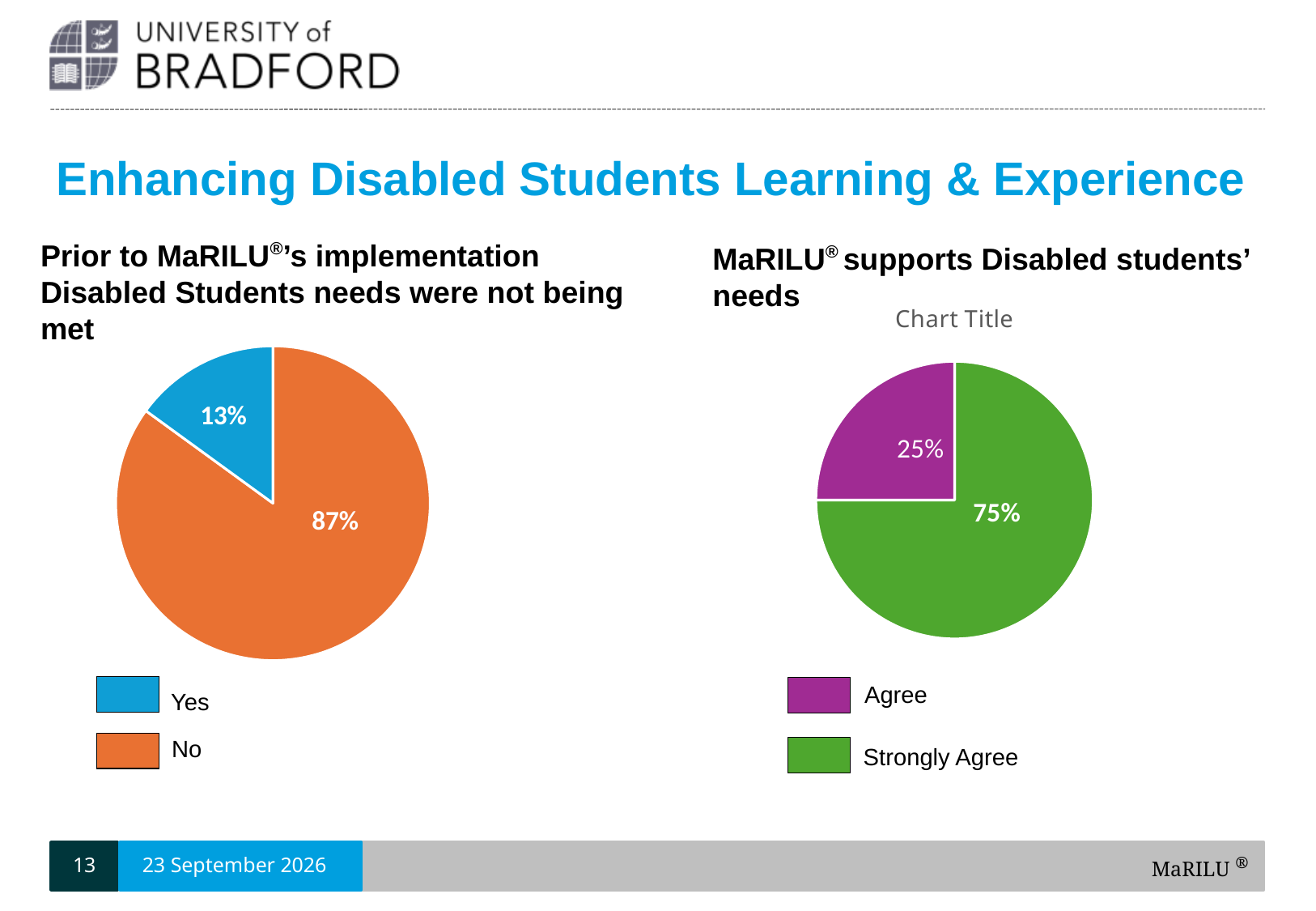
In the left pie chart (Prior to MaRILU's implementation Disabled Students needs were not being met), what percentage is shown for No? 87% In the right pie chart (MaRILU supports Disabled students' needs), what percentage is shown for Strongly Agree? 75% In the right pie chart, what colour is the Strongly Agree slice? Green In the right pie chart (MaRILU supports Disabled students' needs), what percentage is shown for Agree? 25% In the left pie chart (Prior to MaRILU's implementation Disabled Students needs were not being met), what percentage is shown for Yes? 13% In the right pie chart, which is larger: Agree or Strongly Agree? Strongly Agree In the left pie chart, which category has the largest share? No In the right pie chart, what is the difference between the Strongly Agree and Agree percentages? 50% In the left pie chart, what is the difference between the No and Yes percentages? 74% How many slices does the left pie chart have? 2 What type of chart is used on the right side of the slide? Pie chart In the right pie chart, which category has the smallest share? Agree